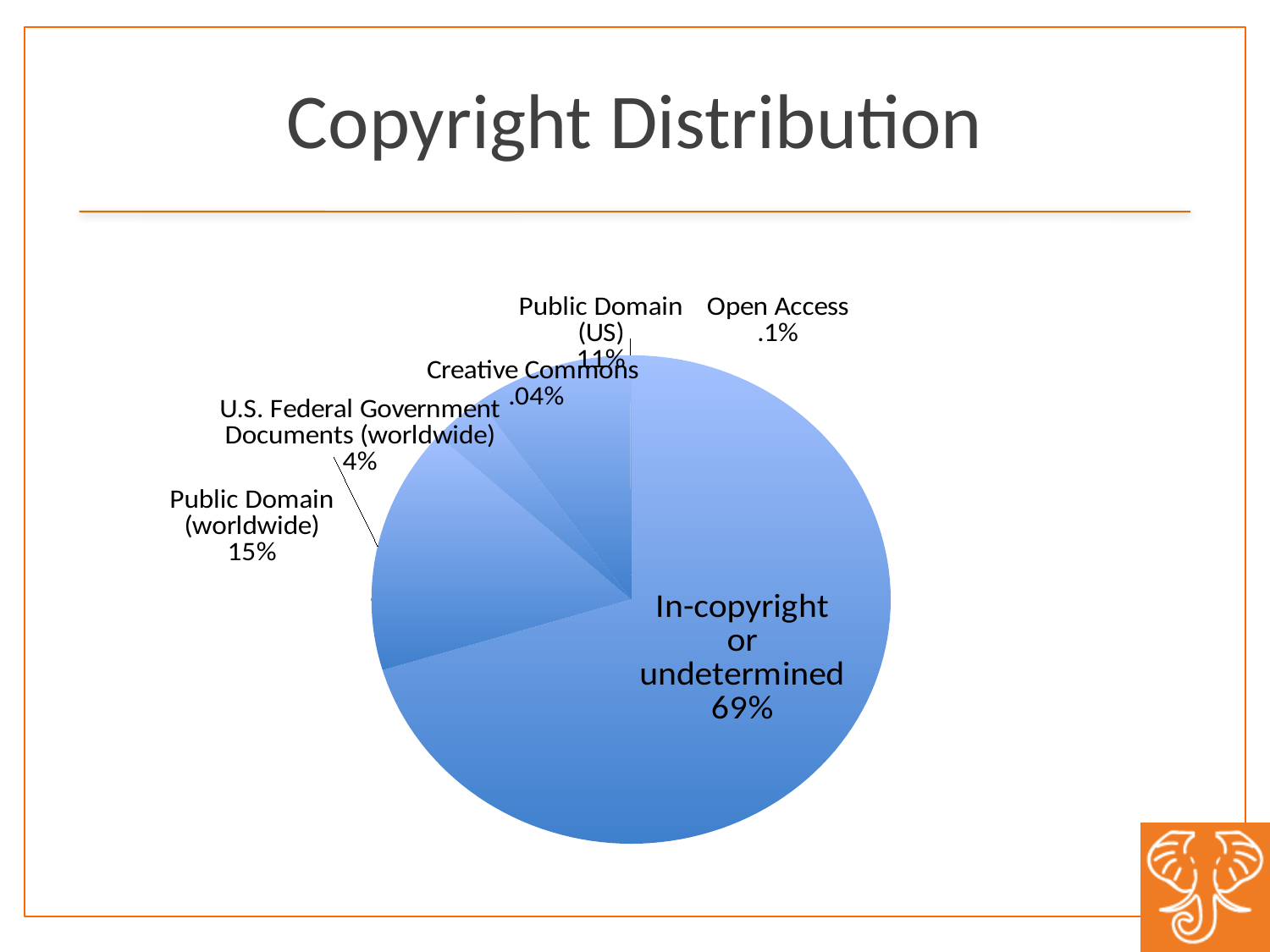
What is the title of the chart? Copyright Distribution What share of the pie is U.S. Federal Government Documents (worldwide)? 4% Which category has the largest slice of the pie? In-copyright or undetermined What share of the pie is Open Access? .1% What kind of chart is shown on the slide? pie chart What share of the pie is Creative Commons? .04% Which is larger, Public Domain (worldwide) or U.S. Federal Government Documents (worldwide)? Public Domain (worldwide) What is the difference in percentage points between In-copyright or undetermined and Public Domain (worldwide)? 54 How many categories are shown in the pie chart? 6 Which category has the smallest slice of the pie? Creative Commons